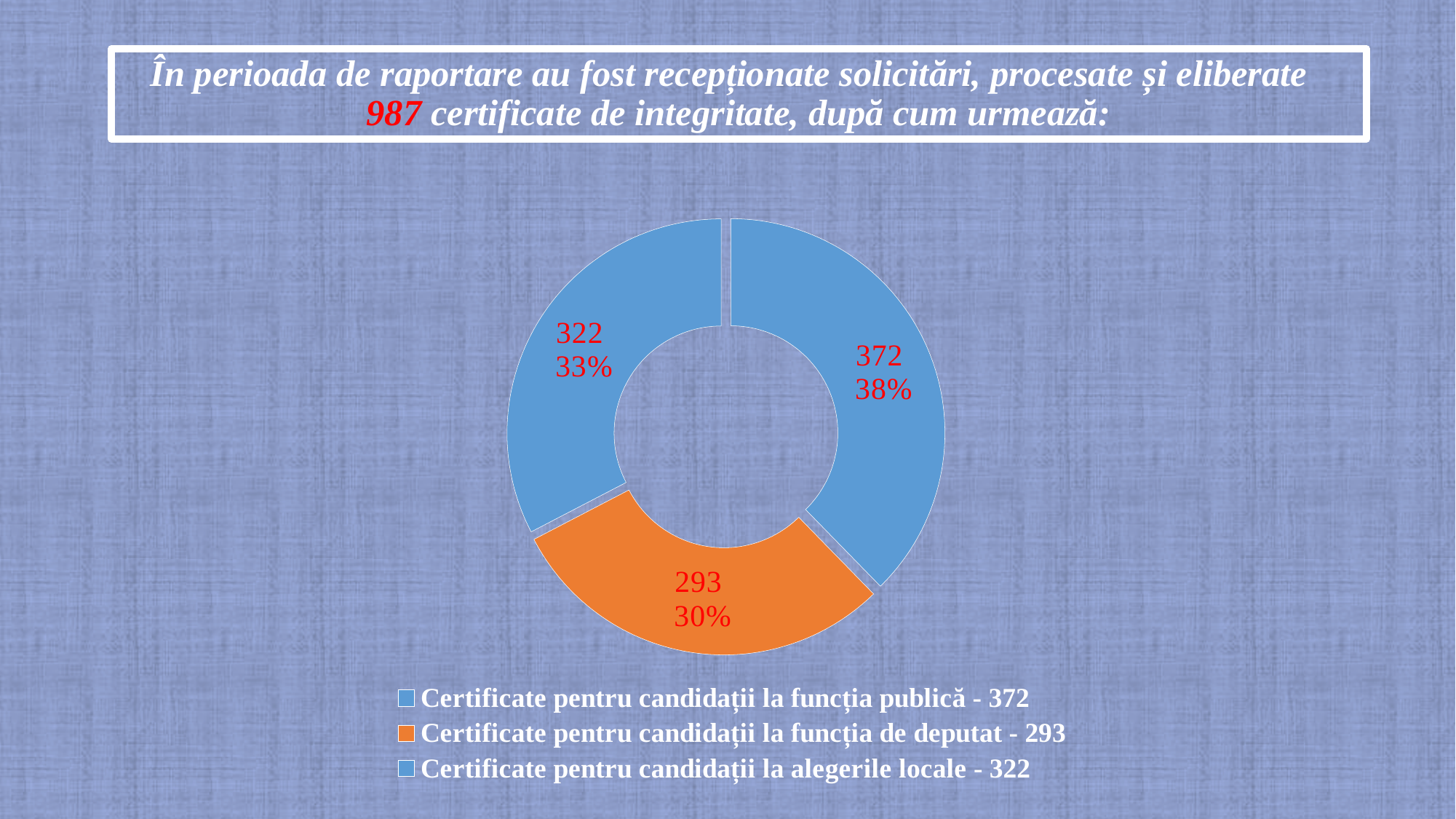
What colour is the slice for certificates for candidates for deputy? Orange What percentage share of the chart do certificates for candidates for public office represent? 38% Which is larger: certificates for local election candidates or certificates for deputy candidates? Certificates for local election candidates (322) How many categories does the chart show? 3 What kind of chart is shown on the slide? Pie (doughnut) chart How many certificates were issued for candidates for the office of deputy (funcția de deputat)? 293 Which category has the smallest number of certificates? Certificate pentru candidații la funcția de deputat - 293 How many certificates were issued for candidates in local elections (alegerile locale)? 322 Which category has the largest number of certificates? Certificate pentru candidații la funcția publică - 372 What is the difference between the number of certificates for public office candidates and for deputy candidates? 79 How many certificates were issued for candidates for public office (funcția publică)? 372 What percentage share of the chart do certificates for candidates for deputy represent? 30%